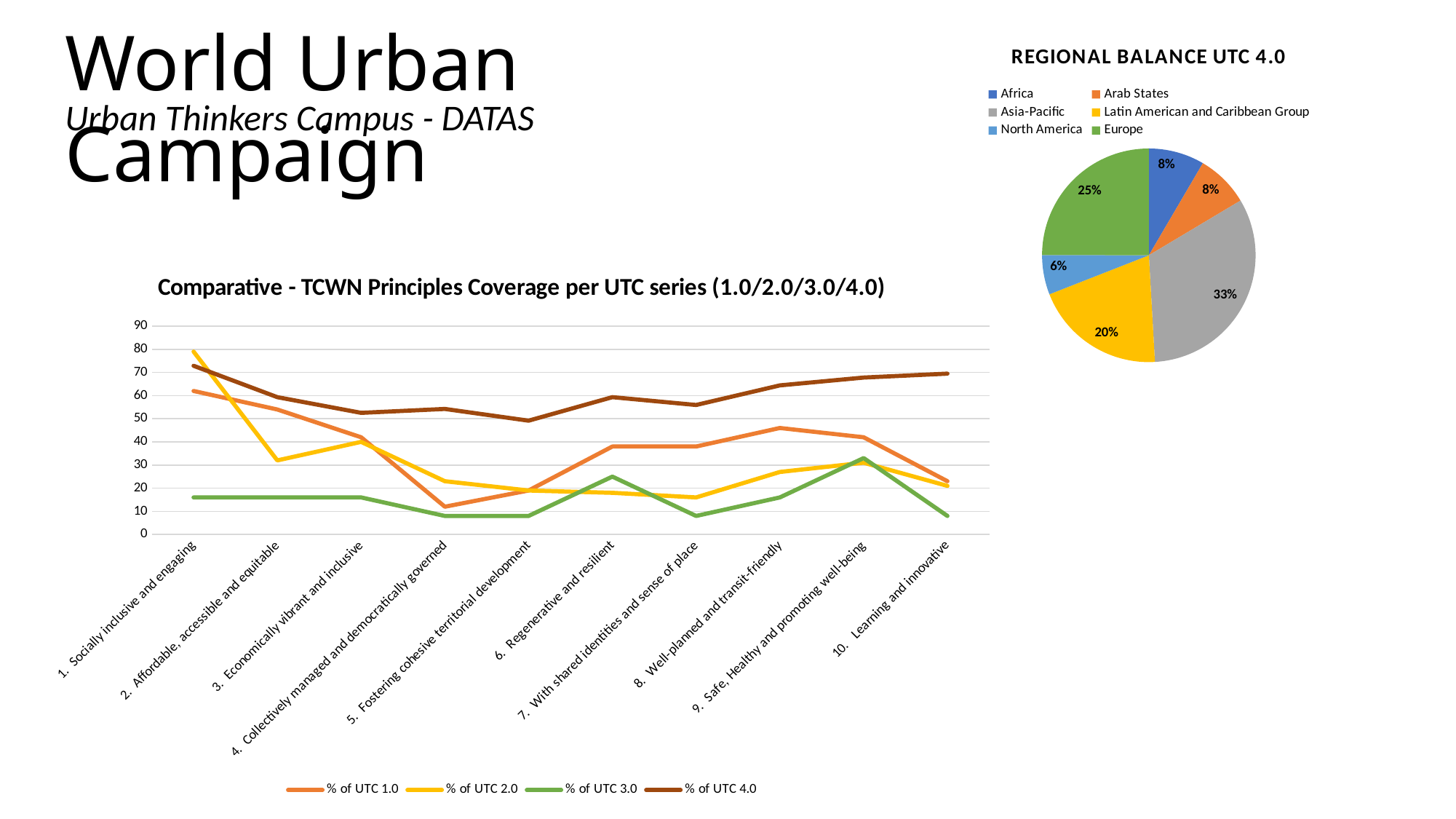
What kind of chart is the Comparative - TCWN Principles Coverage per UTC series chart? Line chart In the REGIONAL BALANCE UTC 4.0 chart, what share does Asia-Pacific have? 33% How many series does the legend of the Comparative - TCWN Principles Coverage per UTC series chart list? 4 In the REGIONAL BALANCE UTC 4.0 chart, which region has the largest share? Asia-Pacific In the REGIONAL BALANCE UTC 4.0 chart, what is the difference in percentage points between Asia-Pacific and Latin American and Caribbean Group? 13 In the REGIONAL BALANCE UTC 4.0 chart, which has the larger share, Europe or Latin American and Caribbean Group? Europe How many regions are shown in the REGIONAL BALANCE UTC 4.0 chart? 6 In the REGIONAL BALANCE UTC 4.0 chart, what share does Europe have? 25% How many principles (categories) are shown on the x axis of the Comparative - TCWN Principles Coverage per UTC series chart? 10 What kind of chart is the REGIONAL BALANCE UTC 4.0 chart? Pie chart In the Comparative - TCWN Principles Coverage per UTC series chart, is the value of % of UTC 4.0 for '1. Socially inclusive and engaging' greater or less than 60? greater In the REGIONAL BALANCE UTC 4.0 chart, which region has the smallest share? North America